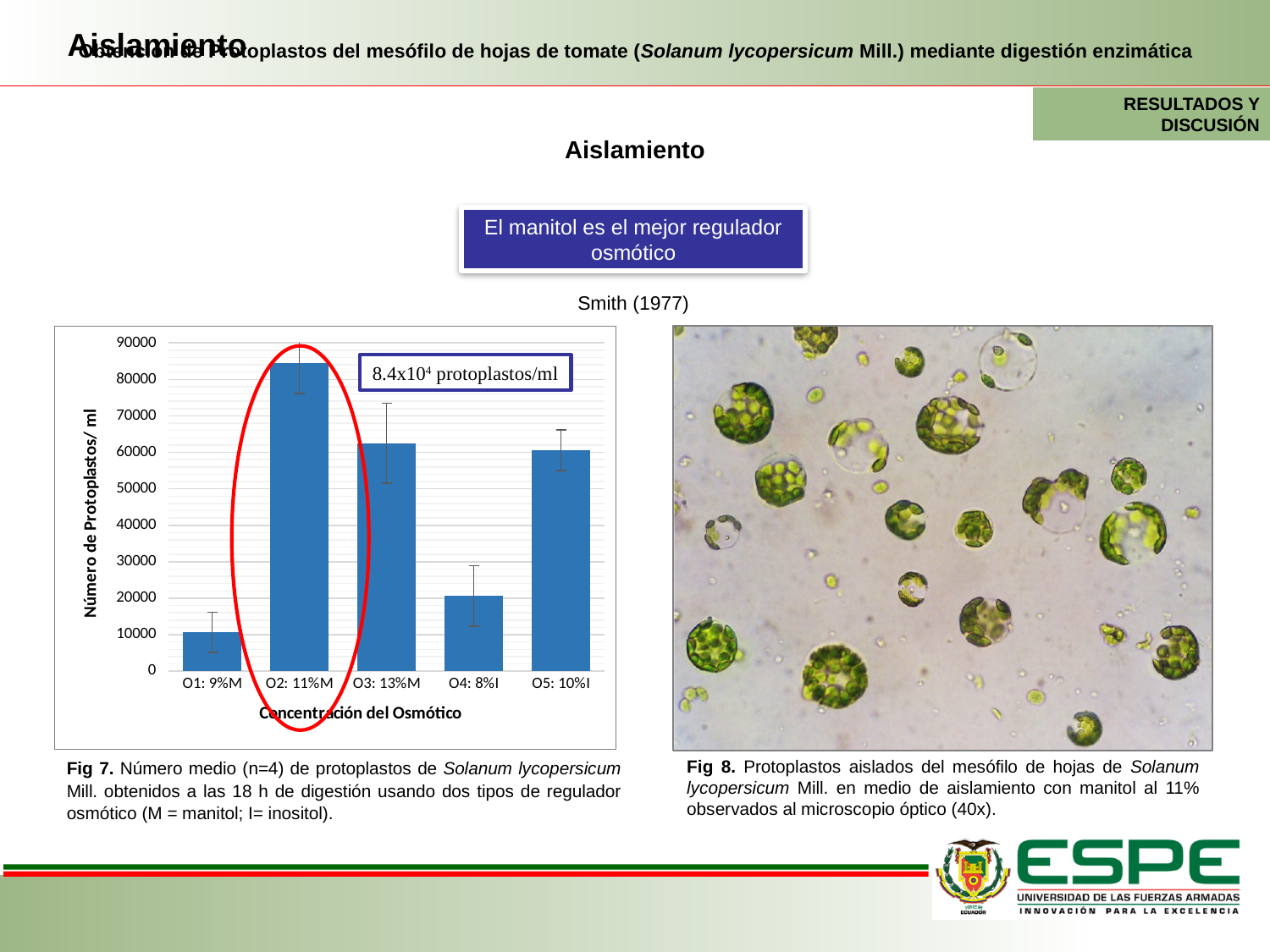
Which has a larger value, O2: 11%M or O3: 13%M? O2: 11%M Is the value for O1: 9%M greater or less than 20000? less Is the value for O3: 13%M greater or less than 50000? greater How many categories are shown on the x axis of the chart? 5 What kind of chart is shown on the slide? bar chart What is the title of the x axis of the chart? Concentración del Osmótico Which category has the highest number of protoplasts per ml? O2: 11%M Which category has the lowest number of protoplasts per ml? O1: 9%M What value is annotated on the chart for the O2: 11%M bar? 8.4x10⁴ protoplastos/ml Is the value for O4: 8%I greater or less than 30000? less What is the title of the y axis of the chart? Número de Protoplastos/ ml Which has a larger value, O1: 9%M or O4: 8%I? O4: 8%I